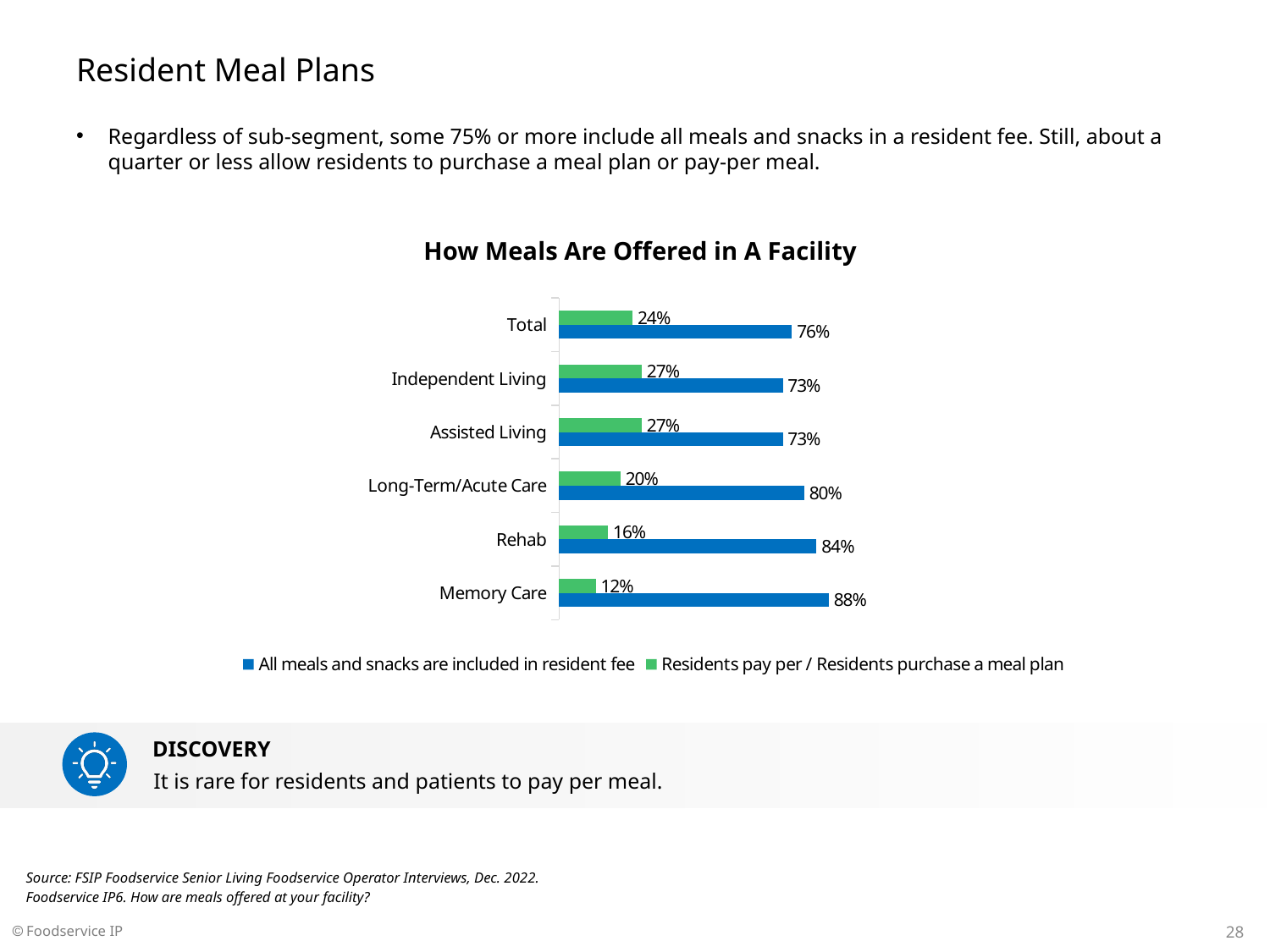
What percentage of Memory Care facilities include all meals and snacks in the resident fee? 88% What kind of chart is shown on the slide? Bar chart What is the value for Residents pay per / Residents purchase a meal plan in the Total category? 24% What percentage of Rehab facilities have residents pay per meal or purchase a meal plan? 16% Which colour represents All meals and snacks are included in resident fee? Blue Which category has the lowest value for Residents pay per / Residents purchase a meal plan? Memory Care Which category has the highest value for All meals and snacks are included in resident fee? Memory Care How many categories are shown on the chart? 6 What is the title of the chart? How Meals Are Offered in A Facility Which is larger: the Independent Living value or the Memory Care value for Residents pay per / Residents purchase a meal plan? Independent Living What is the difference between the Rehab and Long-Term/Acute Care values for All meals and snacks are included in resident fee? 4% How many series does the legend list? 2